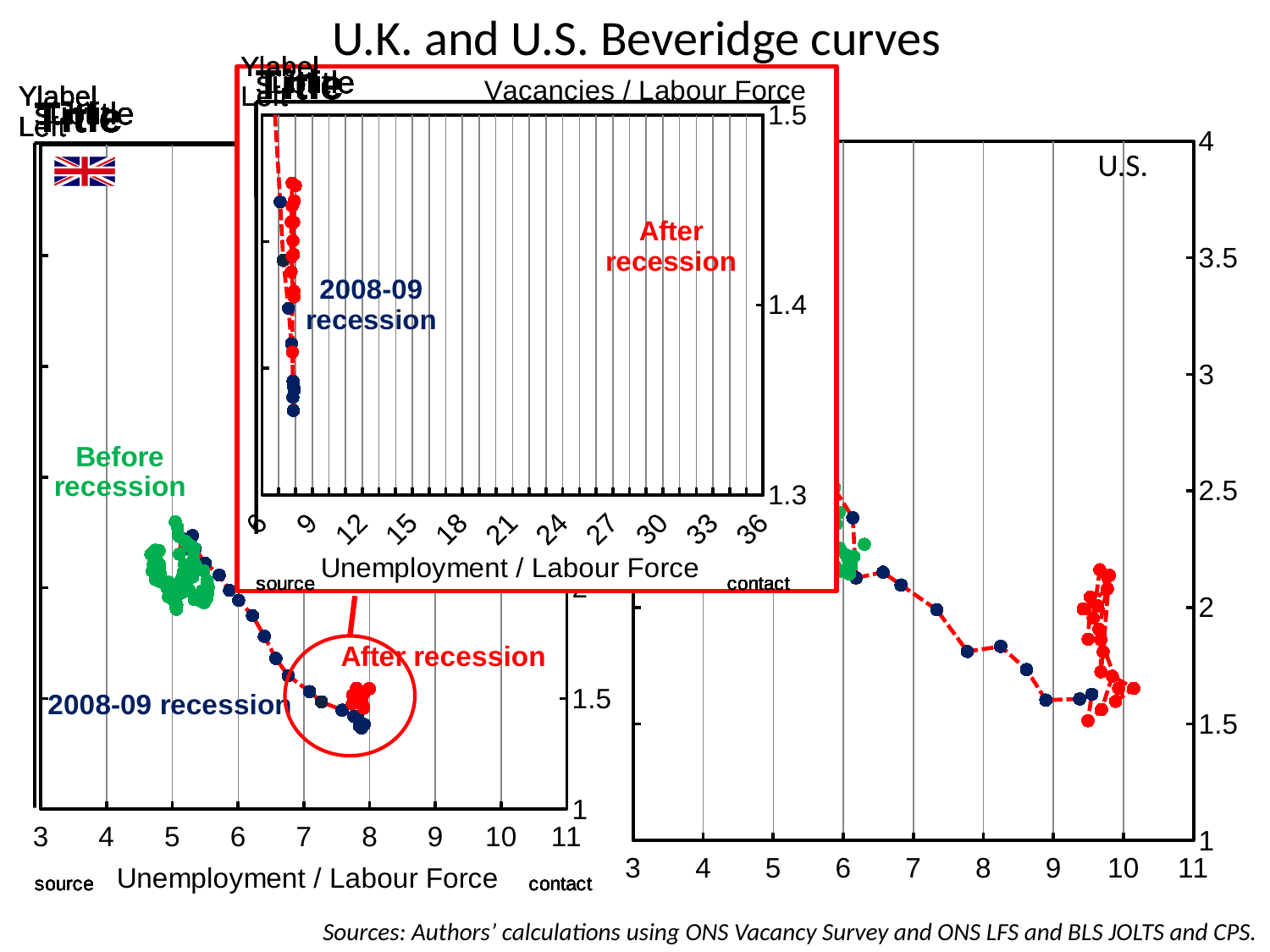
In the U.K. chart on the left, is the unemployment rate of the green 'Before recession' cluster greater or less than 6? less In the U.K. chart on the left, which cluster has the higher vacancy rate: 'Before recession' or 'After recession'? Before recession What is the y-axis label of the inset chart at the top of the slide? Vacancies / Labour Force What kind of chart is the U.K. Beveridge curve chart on the left of the slide? scatter chart In the U.S. chart on the right, is the unemployment rate of the red after-recession cluster greater or less than 9? greater In the U.K. chart on the left, is the unemployment rate of the red 'After recession' cluster greater or less than 7? greater What is the x-axis label of the U.K. chart on the left? Unemployment / Labour Force In the U.K. chart on the left, do vacancies rise or fall as unemployment increases from 5 to 8 along the dashed line? fall In the U.S. chart on the right, which has the higher unemployment rate: the green points or the red points? the red points